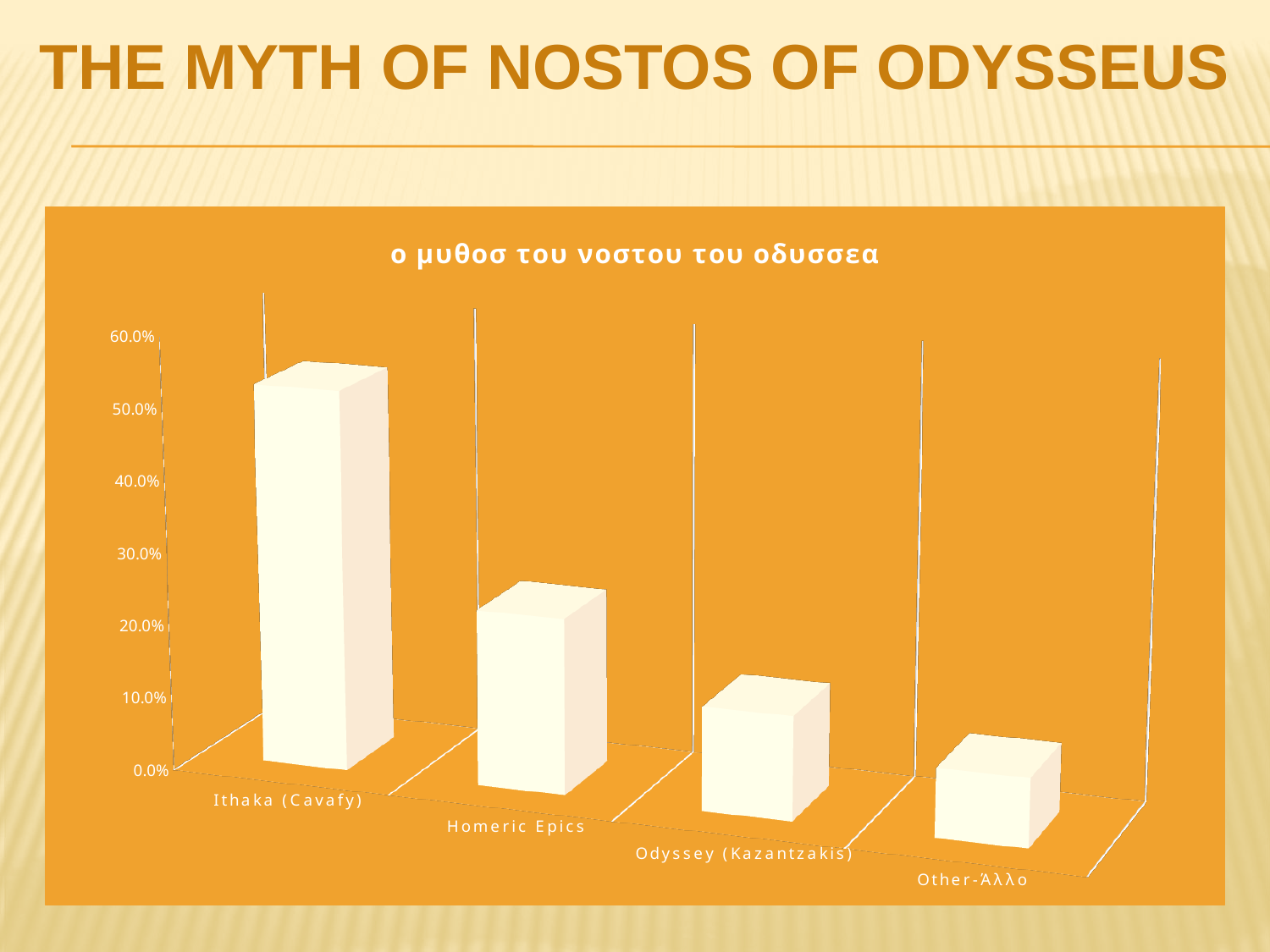
Which has a larger value, Homeric Epics or Odyssey (Kazantzakis)? Homeric Epics What kind of chart is shown on the slide? bar chart Which category has the highest value in the chart? Ithaka (Cavafy) How many categories are shown on the x axis of the chart? 4 Do the values rise or fall moving from left to right along the x axis? fall Is the value for Homeric Epics greater or less than 30.0%? less Is the value for Ithaka (Cavafy) greater or less than 40.0%? greater Which category has the lowest value in the chart? Other-Άλλο What is the title of the chart? ο μυθοσ του νοστου του οδυσσεα Which has a larger value, Ithaka (Cavafy) or Homeric Epics? Ithaka (Cavafy) Is the value for Odyssey (Kazantzakis) greater or less than 20.0%? less